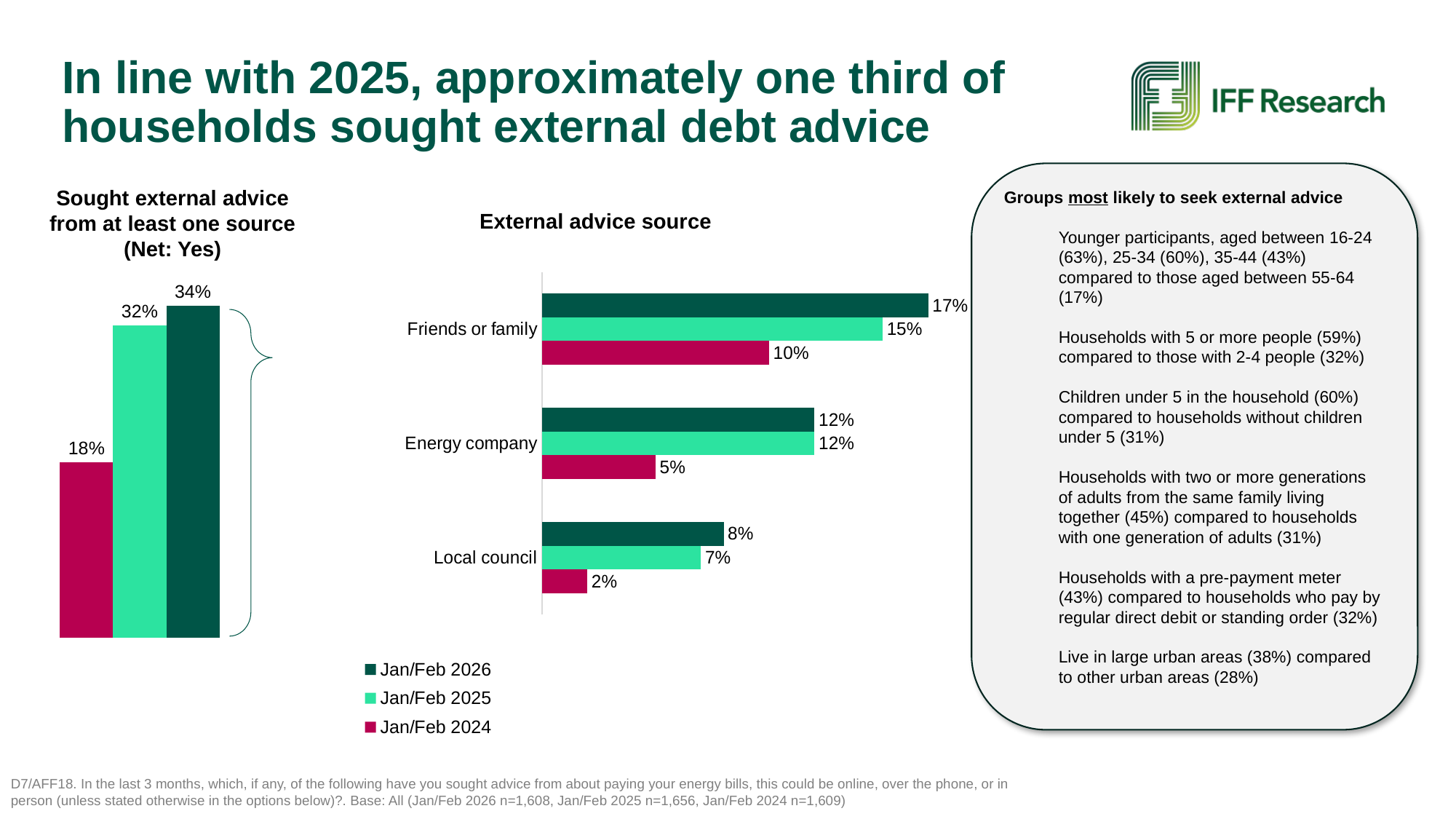
How many series does the legend list for the 'External advice source' chart? 3 In the 'External advice source' chart, which advice source has the highest value for Jan/Feb 2026? Friends or family What type of chart is the 'External advice source' chart? Bar chart In the 'External advice source' chart, what is the difference between the Friends or family values for Jan/Feb 2026 and Jan/Feb 2024? 7% In the 'External advice source' chart, which is larger: Local council in Jan/Feb 2026 or Local council in Jan/Feb 2025? Jan/Feb 2026 In the 'Sought external advice from at least one source (Net: Yes)' chart, what is the difference between the Jan/Feb 2025 and Jan/Feb 2024 values? 14% In the 'External advice source' chart, what is the value for Energy company in Jan/Feb 2025? 12% How many advice source categories are shown in the 'External advice source' chart? 3 In the 'Sought external advice from at least one source (Net: Yes)' chart, what is the value for Jan/Feb 2026? 34% In the 'External advice source' chart, what is the value for Local council in Jan/Feb 2024? 2% In the 'External advice source' chart, what is the value for Friends or family in Jan/Feb 2026? 17% In the 'Sought external advice from at least one source (Net: Yes)' chart, which year has the lowest value? Jan/Feb 2024